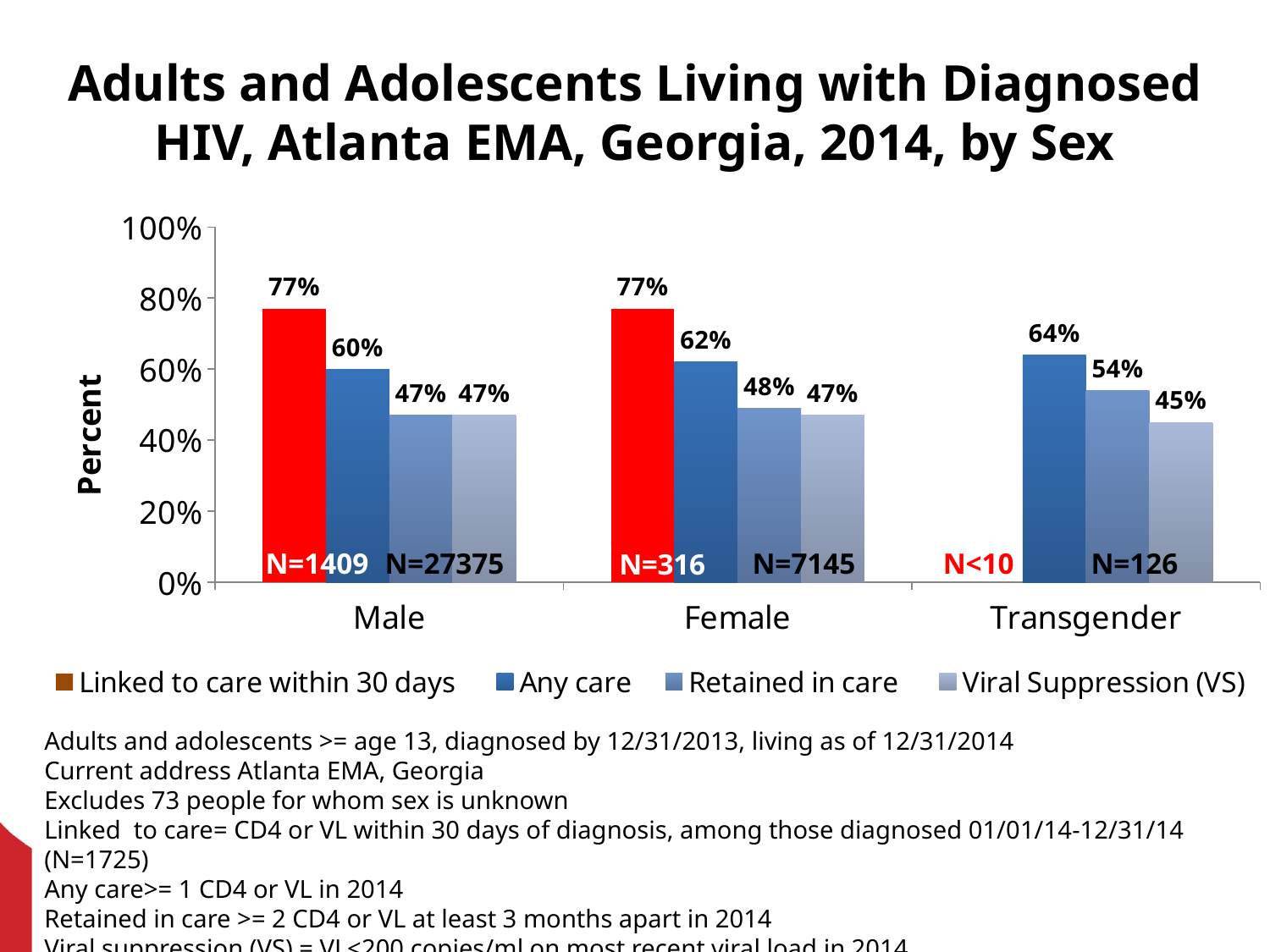
What is the label on the y axis? Percent Which sex category has the lowest Viral Suppression (VS) value? Transgender What is the difference between the Any care values for Transgender and Male? 4% How many series does the legend list? 4 What is the Retained in care value for Female? 48% What is the N shown for the Linked to care within 30 days bar for Female? N=316 What is the Viral Suppression (VS) value for Transgender? 45% What kind of chart is shown on the slide? Bar chart Which is larger, the Retained in care value for Transgender or for Female? Transgender Which sex category has the highest Any care value? Transgender What is the Any care value for Male? 60% How many sex categories are shown on the x axis? 3